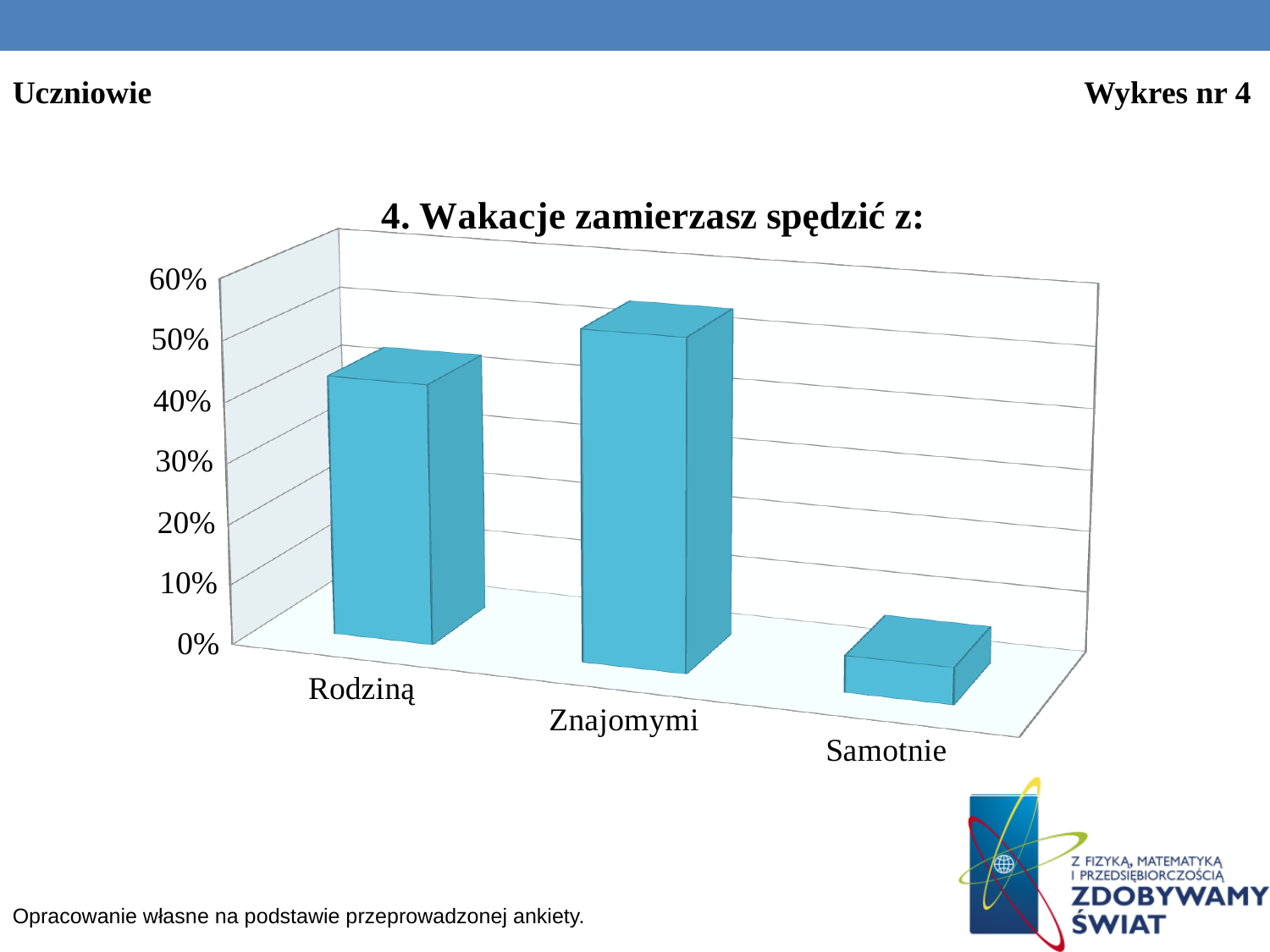
How many categories are shown on the chart? 3 What is the title of the chart? 4. Wakacje zamierzasz spędzić z: Is the value for Znajomymi greater or less than 40%? greater What kind of chart is shown on the slide? bar chart Which category has the lowest value? Samotnie Which is larger, the value for Rodziną or the value for Znajomymi? Znajomymi Is the value for Znajomymi greater or less than 60%? less Which is larger, the value for Rodziną or the value for Samotnie? Rodziną What is the highest value shown on the vertical axis? 60% Is the value for Rodziną greater or less than 30%? greater Which category has the highest value? Znajomymi